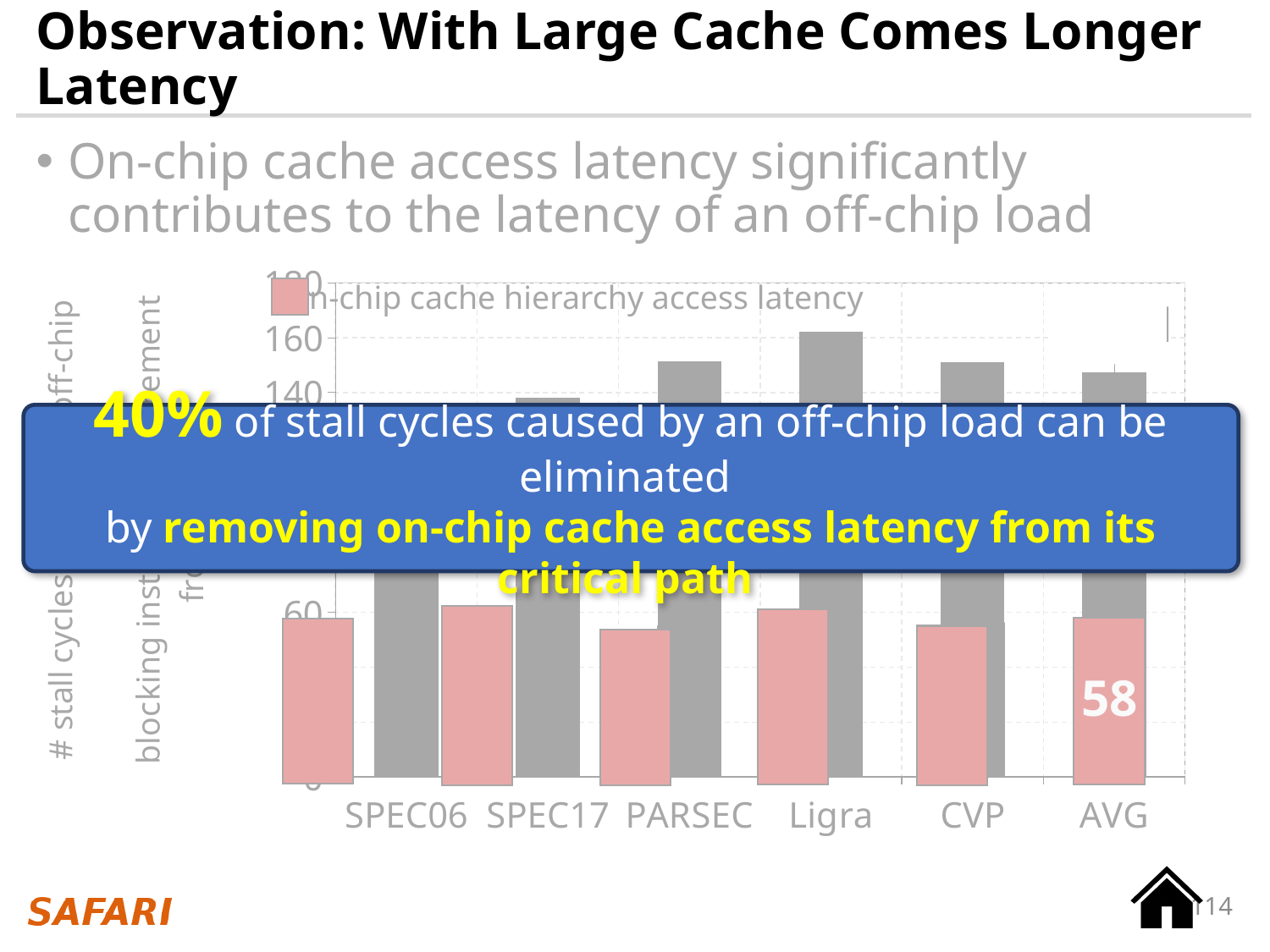
Which category has the tallest gray bar? Ligra For AVG, which bar is taller, the gray bar or the pink on-chip cache hierarchy access latency bar? the gray bar What is the value printed on the AVG bar for on-chip cache hierarchy access latency? 58 How many categories are shown on the x axis of the chart? 6 Is the gray bar for Ligra greater or less than 140? greater Which is larger, the gray bar for Ligra or the gray bar for CVP? Ligra What colour are the bars for on-chip cache hierarchy access latency? pink What kind of chart is shown on the slide? bar chart Which category is the last one on the x axis? AVG Is the gray bar for PARSEC greater or less than 140? greater Is the pink on-chip cache hierarchy access latency bar for PARSEC greater or less than 60? less